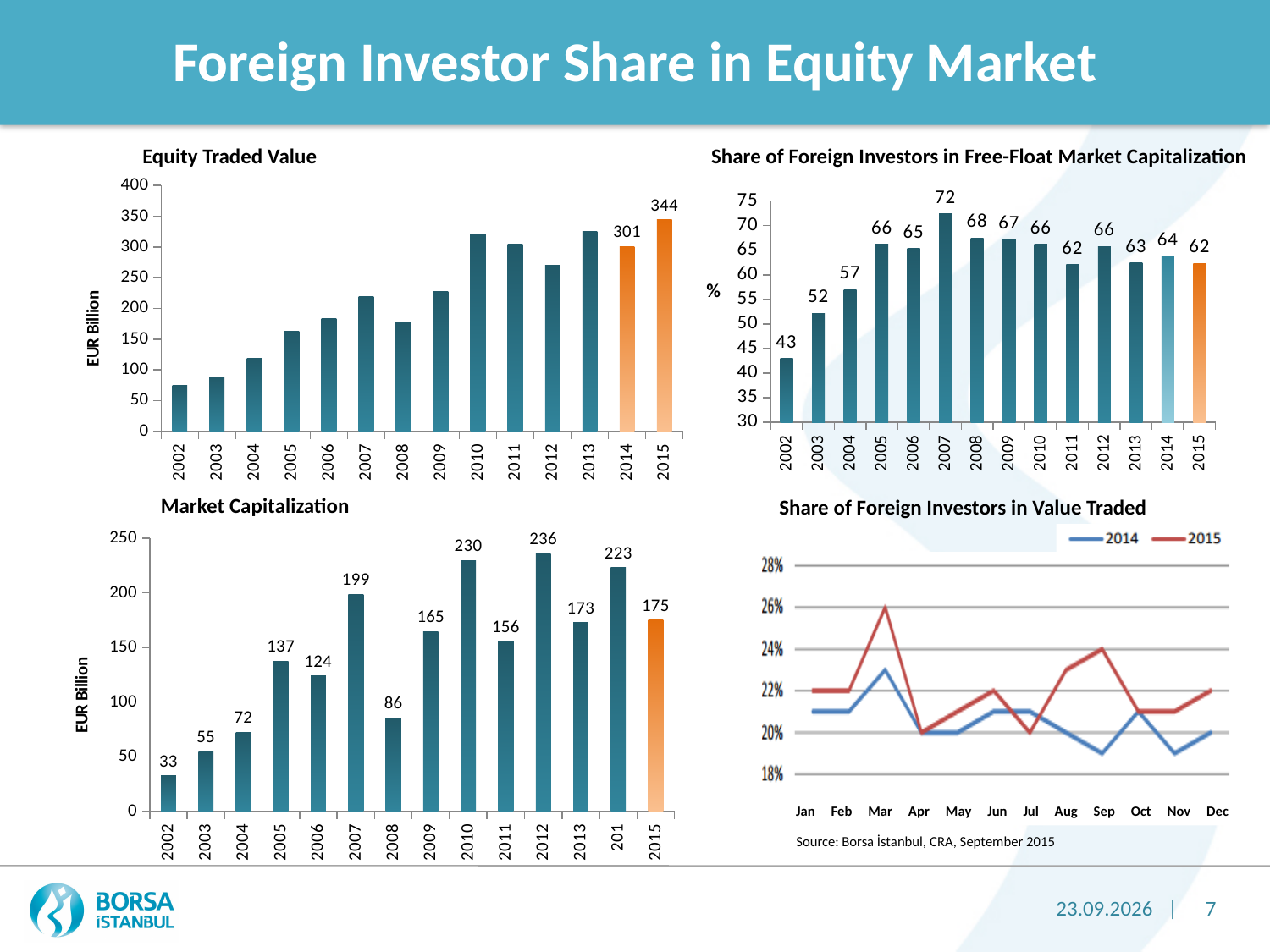
What kind of chart is the Share of Foreign Investors in Value Traded chart? line chart In the Market Capitalization chart, what is the value for 2008? 86 In the Equity Traded Value chart, how many years are shown on the x axis? 14 In the Equity Traded Value chart, what is the value for 2015? 344 In the Share of Foreign Investors in Value Traded chart, how many series does the legend list? 2 In the Equity Traded Value chart, what is the difference between the 2015 and 2014 values? 43 In the Share of Foreign Investors in Free-Float Market Capitalization chart, what is the difference between the 2007 and 2002 values? 29 In the Market Capitalization chart, which year has the highest value? 2012 In the Equity Traded Value chart, is the value for 2002 greater or less than 100? less In the Share of Foreign Investors in Free-Float Market Capitalization chart, which year has the highest value? 2007 In the Market Capitalization chart, which year has the lowest value? 2002 In the Share of Foreign Investors in Free-Float Market Capitalization chart, what is the value for 2002? 43